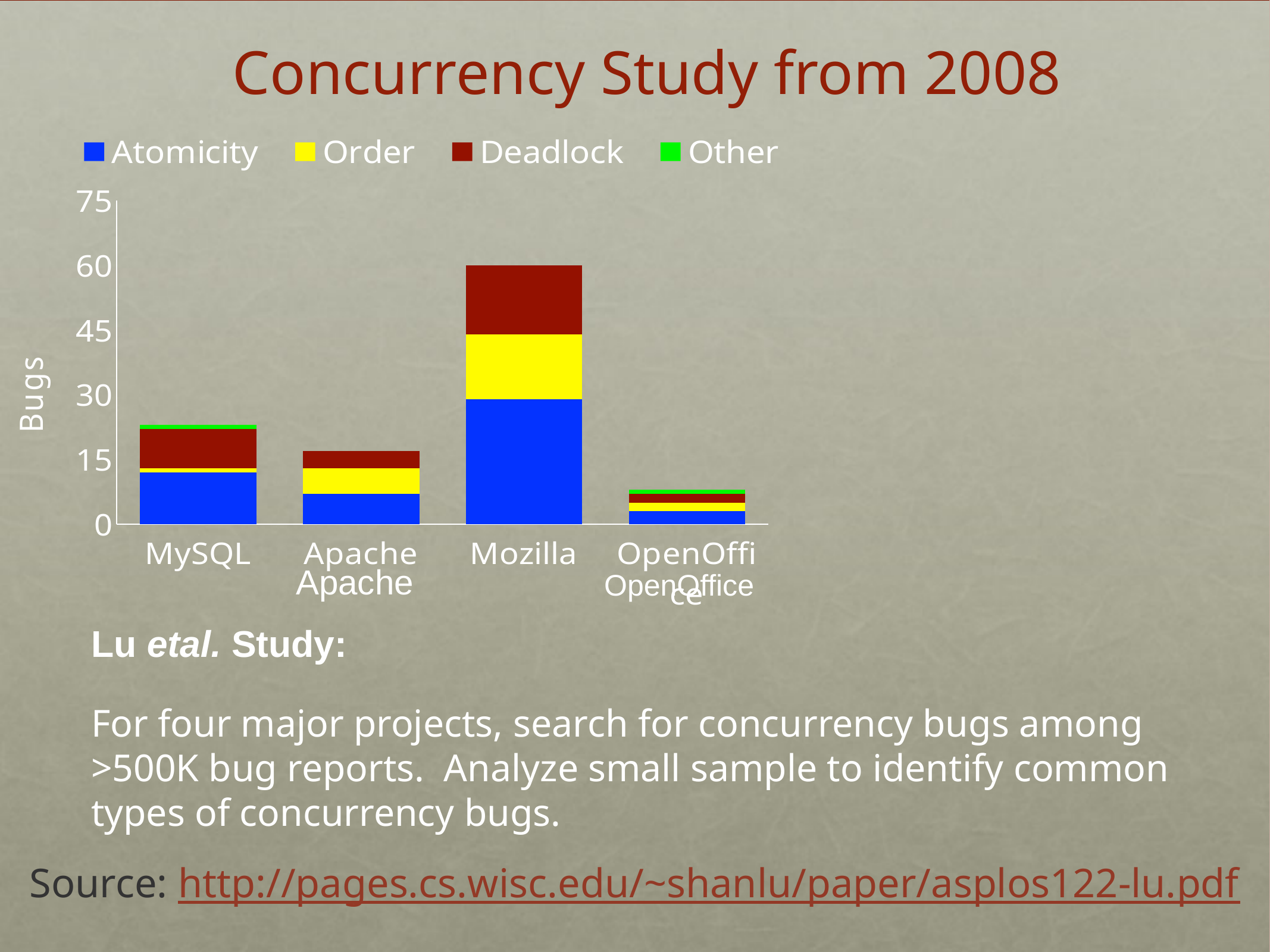
What kind of chart is shown on the slide? stacked bar chart Which project has more total bugs, MySQL or Apache? MySQL Which series is shown in yellow in the legend? Order How many projects (categories) are shown on the x axis? 4 What is the label on the y axis? Bugs How many series does the legend list? 4 Is the total number of bugs for MySQL greater or less than 30? less Is the Atomicity value for Mozilla greater or less than 15? greater Is the total number of bugs for OpenOffice greater or less than 15? less Which project has the shortest stacked bar (fewest bugs in total)? OpenOffice Which project has the tallest stacked bar (most bugs in total)? Mozilla